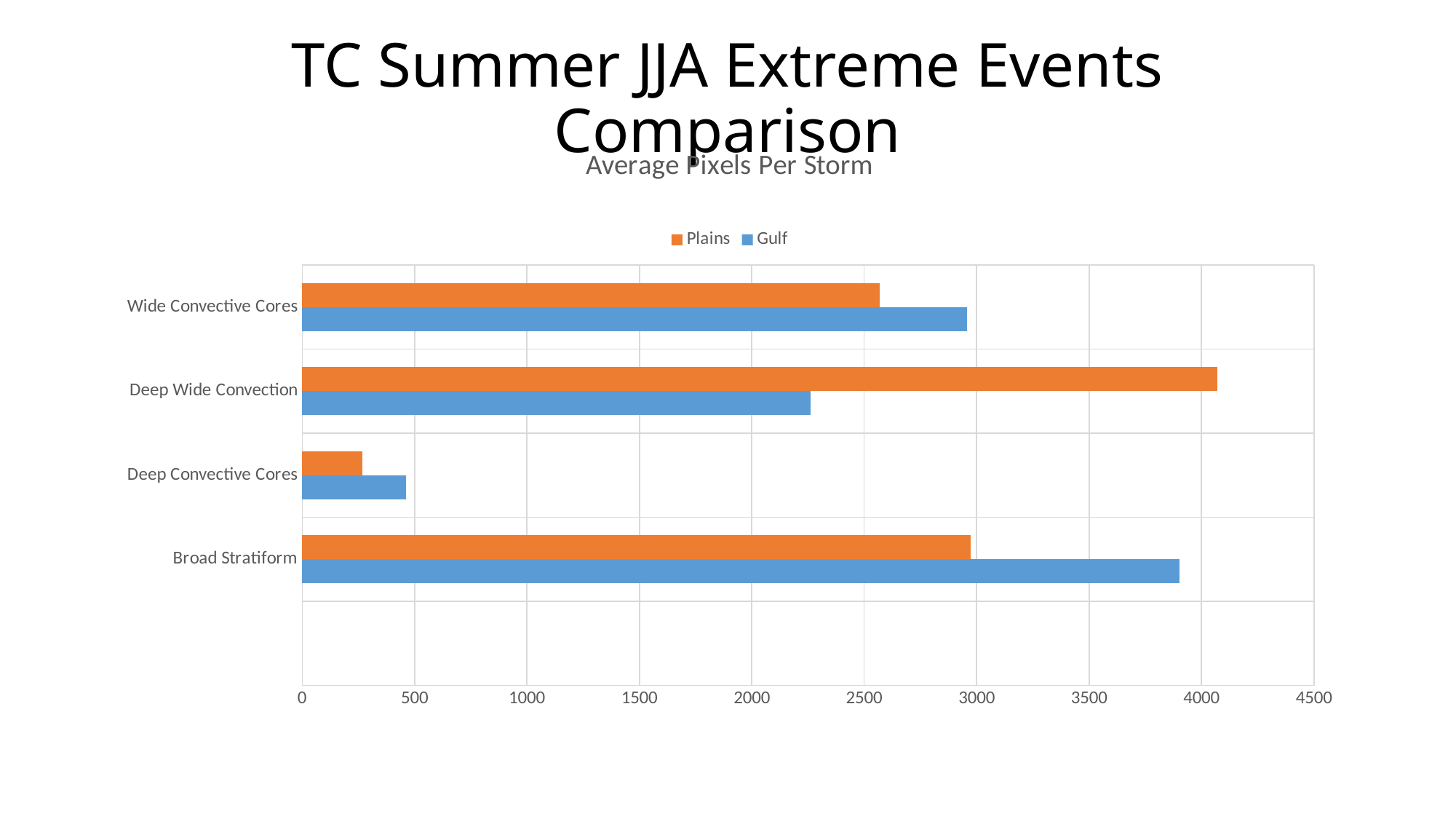
Which category has the highest Gulf value? Broad Stratiform For Broad Stratiform, which is larger, Plains or Gulf? Gulf Which category has the highest Plains value? Deep Wide Convection For Deep Wide Convection, which is larger, Plains or Gulf? Plains What is the title of the chart? Average Pixels Per Storm Is the Gulf value for Broad Stratiform greater or less than 3500? greater How many series does the legend list? 2 Which category has the lowest Gulf value? Deep Convective Cores Is the Gulf value for Deep Convective Cores greater or less than 500? less How many categories are shown on the chart? 4 Is the Plains value for Deep Wide Convection greater or less than 3500? greater What kind of chart is shown on the slide? bar chart